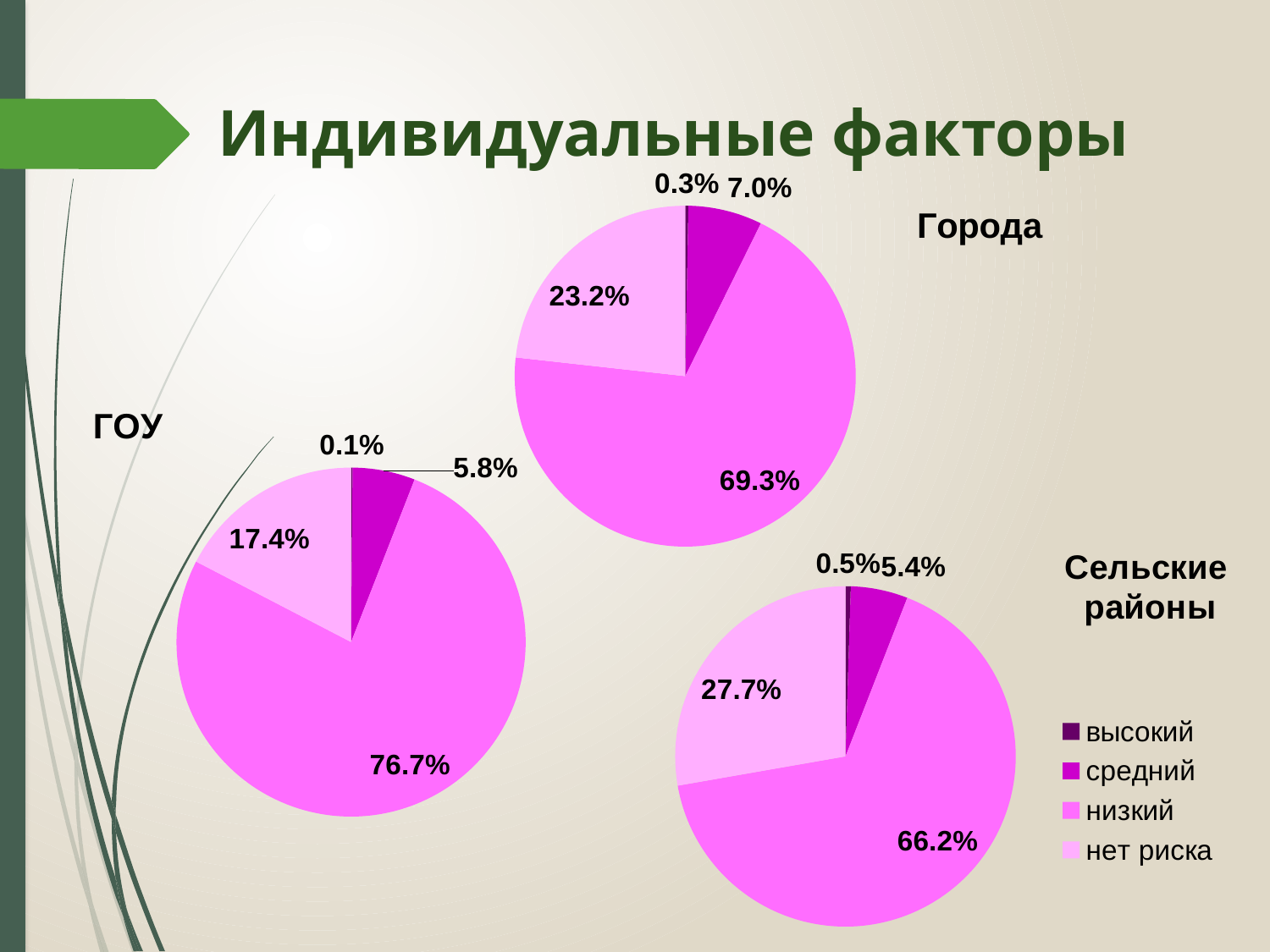
In the ГОУ pie chart, which category has the smallest share? высокий What type of chart is used for the ГОУ data? Pie chart In the Города pie chart, which category has the largest share? низкий In the Сельские районы pie chart, what is the share of the высокий category? 0.5% In the Сельские районы pie chart, what is the share of the средний category? 5.4% In the Сельские районы pie chart, what is the difference between the низкий share and the нет риска share? 38.5% How many pie charts are shown on the slide? 3 In the Города pie chart, what is the share of the нет риска category? 23.2% Which is larger: the нет риска share in the Города chart or in the ГОУ chart? Города In the ГОУ pie chart, what is the share of the низкий category? 76.7% How many categories does the legend list? 4 How many slices does the Города pie chart have? 4